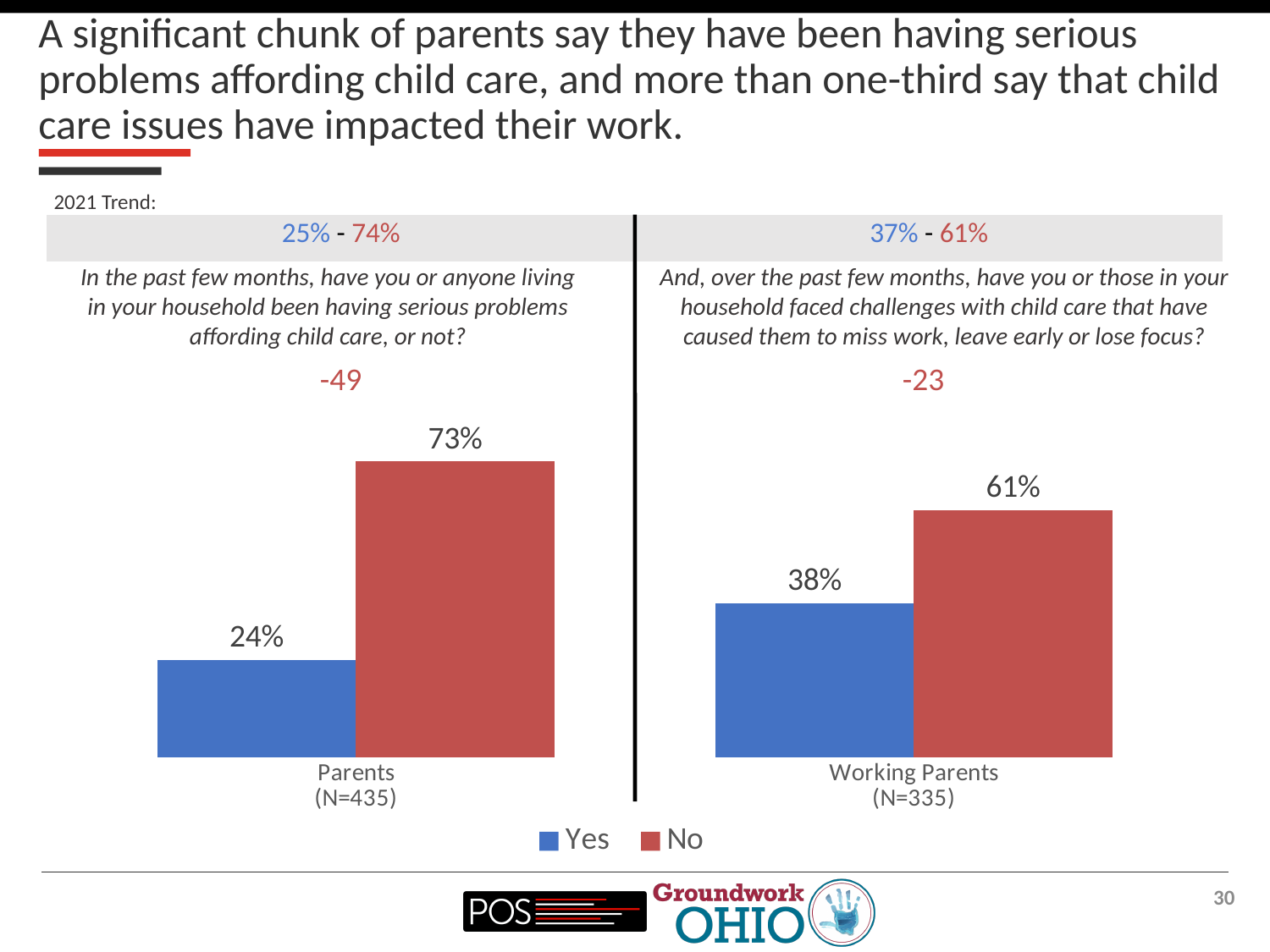
Which chart has the higher Yes value, the left chart (Parents) or the right chart (Working Parents)? Working Parents In the left chart (Parents, N=435), what percentage answered No? 73% In the right chart (Working Parents), what is the difference between the No and Yes percentages? 23 How many series does the legend list? 2 What type of chart is used on this slide? Bar chart In the right chart (Working Parents, N=335), what percentage answered No? 61% In the right chart (Working Parents, N=335), what percentage answered Yes? 38% In the left chart (Parents, N=435), what percentage answered Yes? 24% In the right chart (Working Parents), which response has the lower value? Yes What are the two entries in the legend? Yes and No In the left chart (Parents), what is the difference between the No and Yes percentages? 49 In the left chart (Parents), which response has the higher value, Yes or No? No